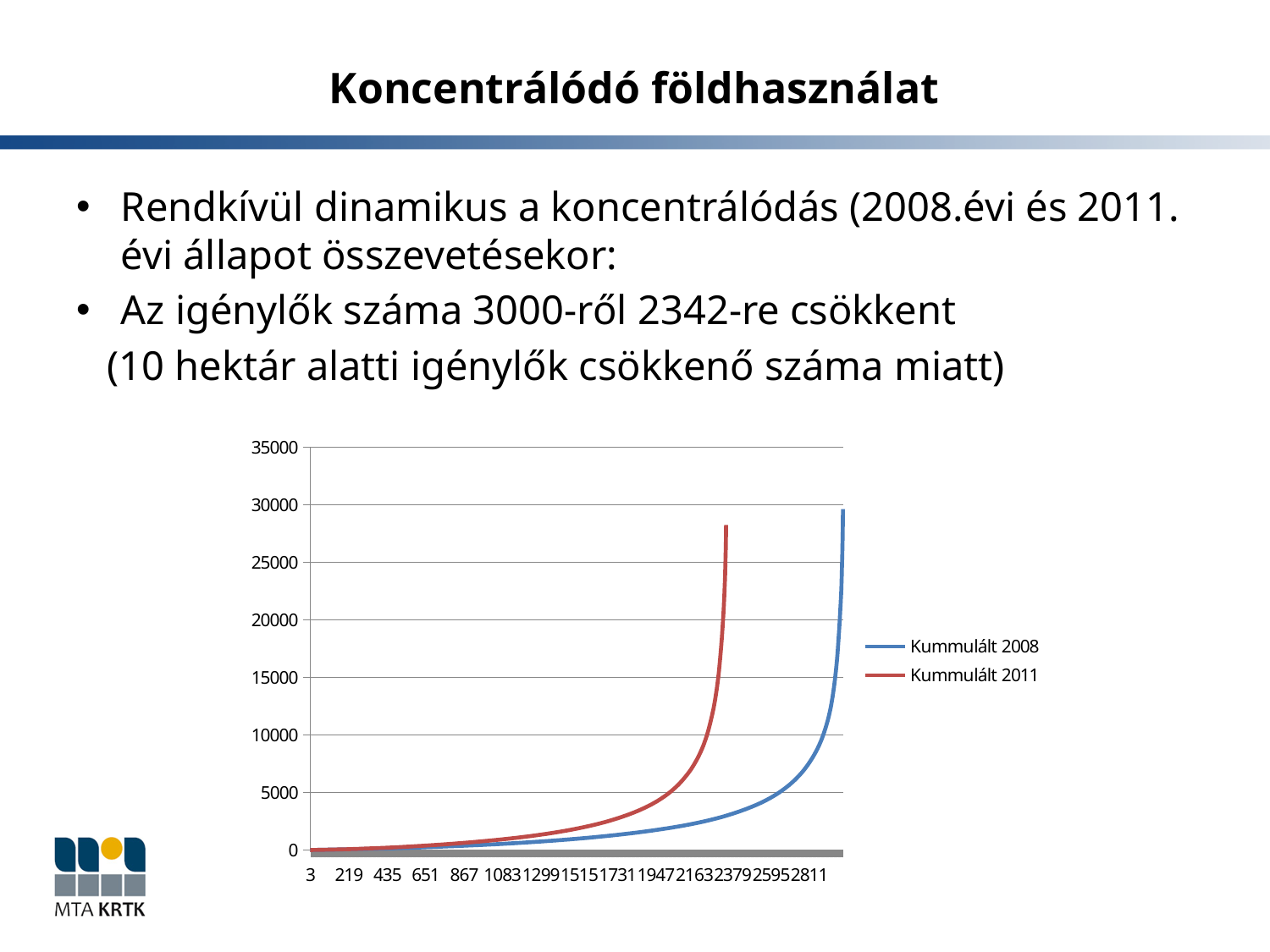
How many series does the chart's legend list? 2 Is the highest value reached by the Kummulált 2011 line greater or less than 25000? greater What kind of chart is shown on the slide? line chart What are the two series named in the chart's legend? Kummulált 2008 and Kummulált 2011 Do the values of the Kummulált 2011 series rise or fall along the x axis? rise How many tick labels are printed on the x axis of the chart? 14 Which colour is used for the Kummulált 2011 series? red Which series extends further to the right along the x axis, Kummulált 2008 or Kummulált 2011? Kummulált 2008 Is the highest value reached by the Kummulált 2008 line greater or less than 25000? greater Do the values of the Kummulált 2008 series rise or fall along the x axis? rise What is the highest value shown on the y axis of the chart? 35000 Is the highest value reached by the Kummulált 2011 line greater or less than 30000? less